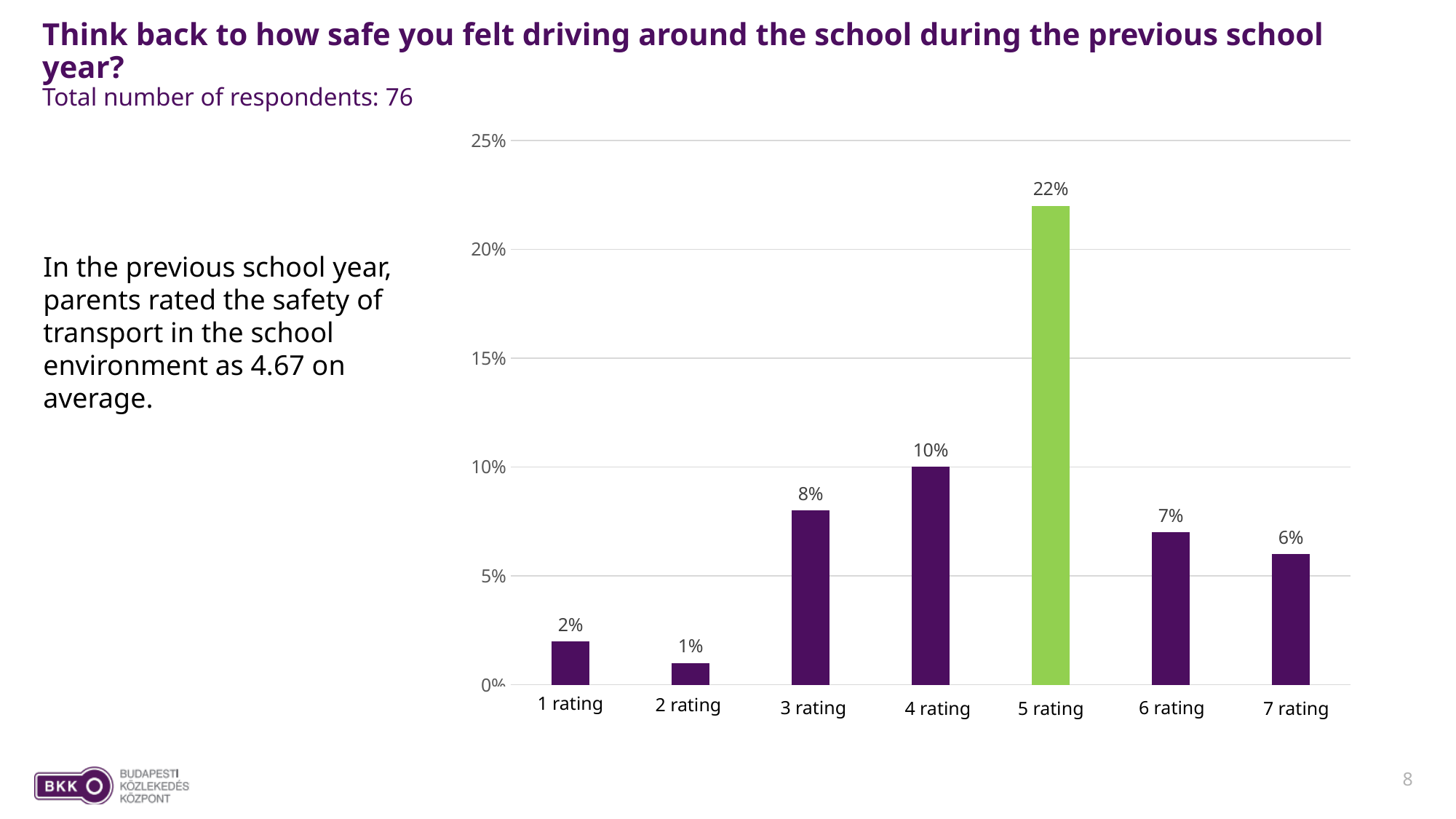
Which rating category has the highest value? 5 rating What is the value for 3 rating? 8% How many rating categories are shown on the x axis? 7 Which rating category has the lowest value? 2 rating What is the difference between the values for 5 rating and 4 rating? 12% Which is larger, the value for 6 rating or the value for 7 rating? 6 rating What is the value for 1 rating? 2% Do the values rise or fall from 1 rating to 5 rating? rise Is the value for 4 rating greater or less than 15%? less What kind of chart is shown on the slide? bar chart What is the value for 5 rating? 22% Which bar is coloured green rather than purple? 5 rating